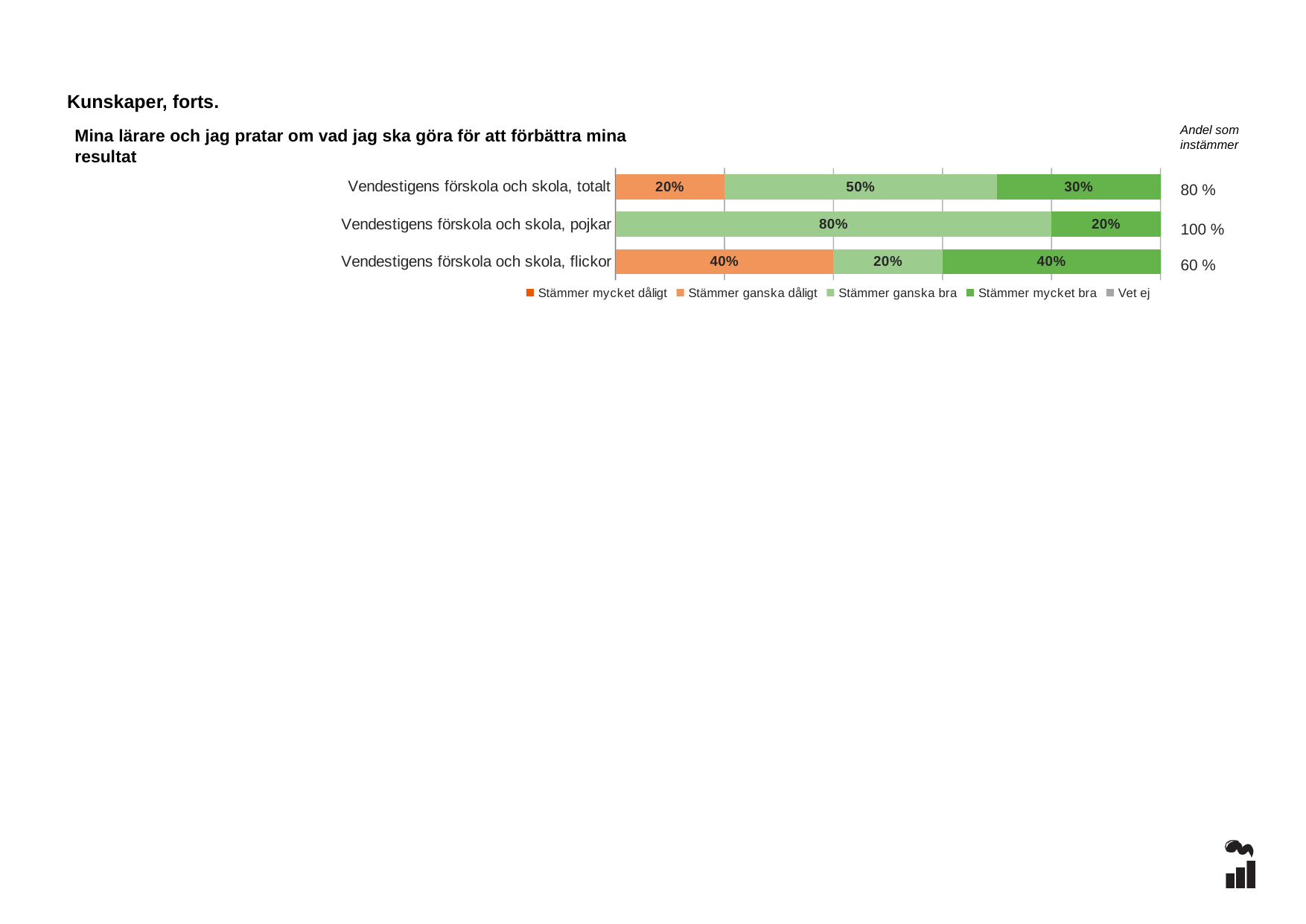
What is the "Andel som instämmer" value shown for "Vendestigens förskola och skola, pojkar"? 100 % How many series does the legend list? 5 What kind of chart is shown on the slide? Stacked bar chart Which is larger: the "Stämmer mycket bra" value for "flickor" or for "totalt"? Vendestigens förskola och skola, flickor What is the value of "Stämmer ganska bra" for "Vendestigens förskola och skola, pojkar"? 80% What is the value of "Stämmer ganska bra" for "Vendestigens förskola och skola, totalt"? 50% What is the difference between the "Stämmer ganska dåligt" values for "flickor" and "totalt"? 20% Which category has the lowest "Stämmer ganska bra" value? Vendestigens förskola och skola, flickor What is the value of "Stämmer mycket bra" for "Vendestigens förskola och skola, pojkar"? 20% How many categories (bars) are shown in the chart? 3 What is the value of "Stämmer ganska dåligt" for "Vendestigens förskola och skola, flickor"? 40% Which category has the highest "Stämmer ganska bra" value? Vendestigens förskola och skola, pojkar